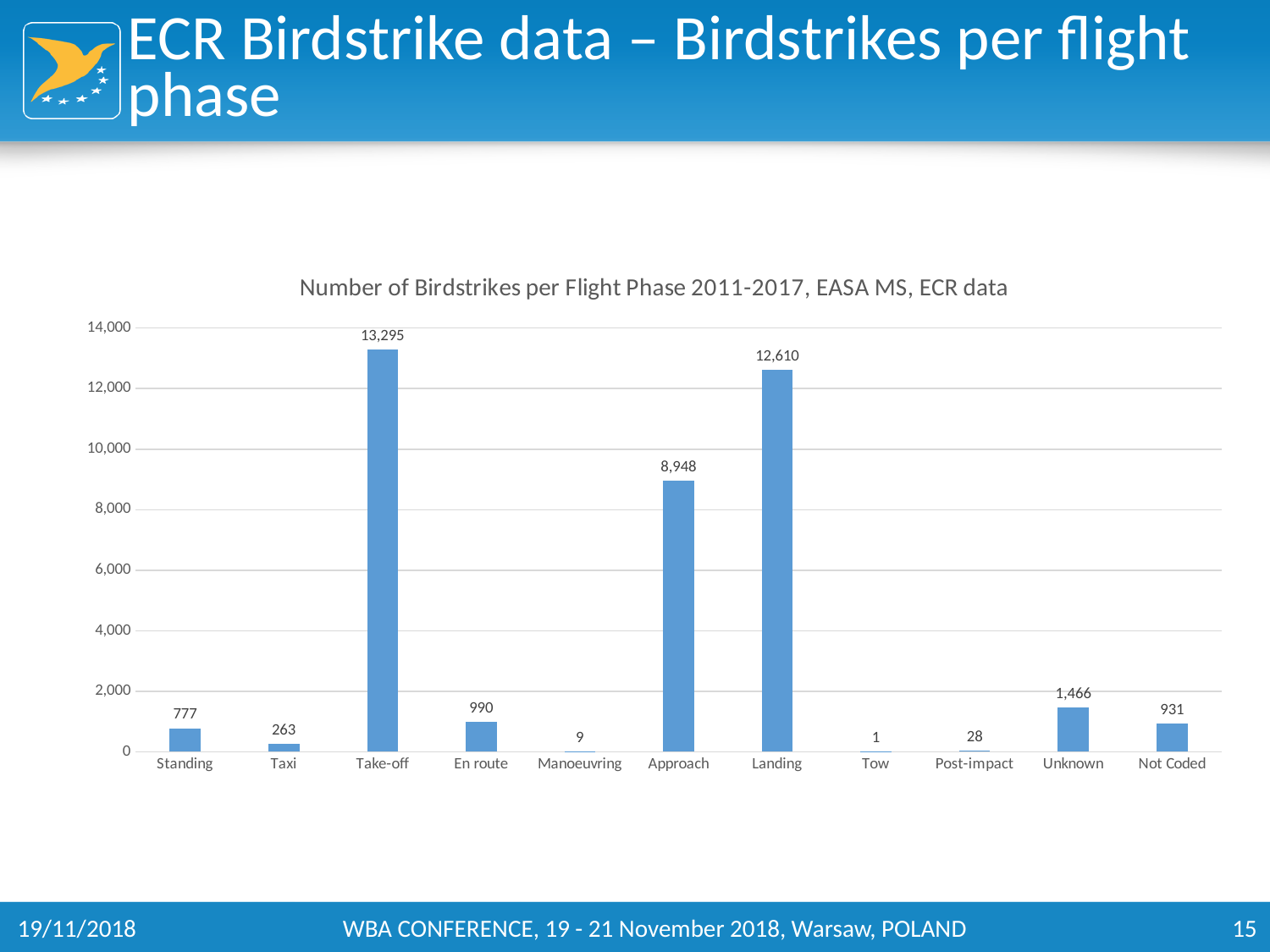
What is the difference between the number of birdstrikes for Unknown and Not Coded? 535 What is the number of birdstrikes during Take-off? 13,295 Which flight phase has the highest number of birdstrikes? Take-off Is the value for Landing greater or less than 12,000? greater What is the difference between the number of birdstrikes during Take-off and during Landing? 685 What is the title of the chart? Number of Birdstrikes per Flight Phase 2011-2017, EASA MS, ECR data Which flight phase has the lowest number of birdstrikes? Tow What is the number of birdstrikes for the Unknown flight phase? 1,466 What kind of chart is shown on the slide? Bar chart How many flight phase categories are shown on the x axis? 11 Which has more birdstrikes, Standing or En route? En route What is the number of birdstrikes during Approach? 8,948